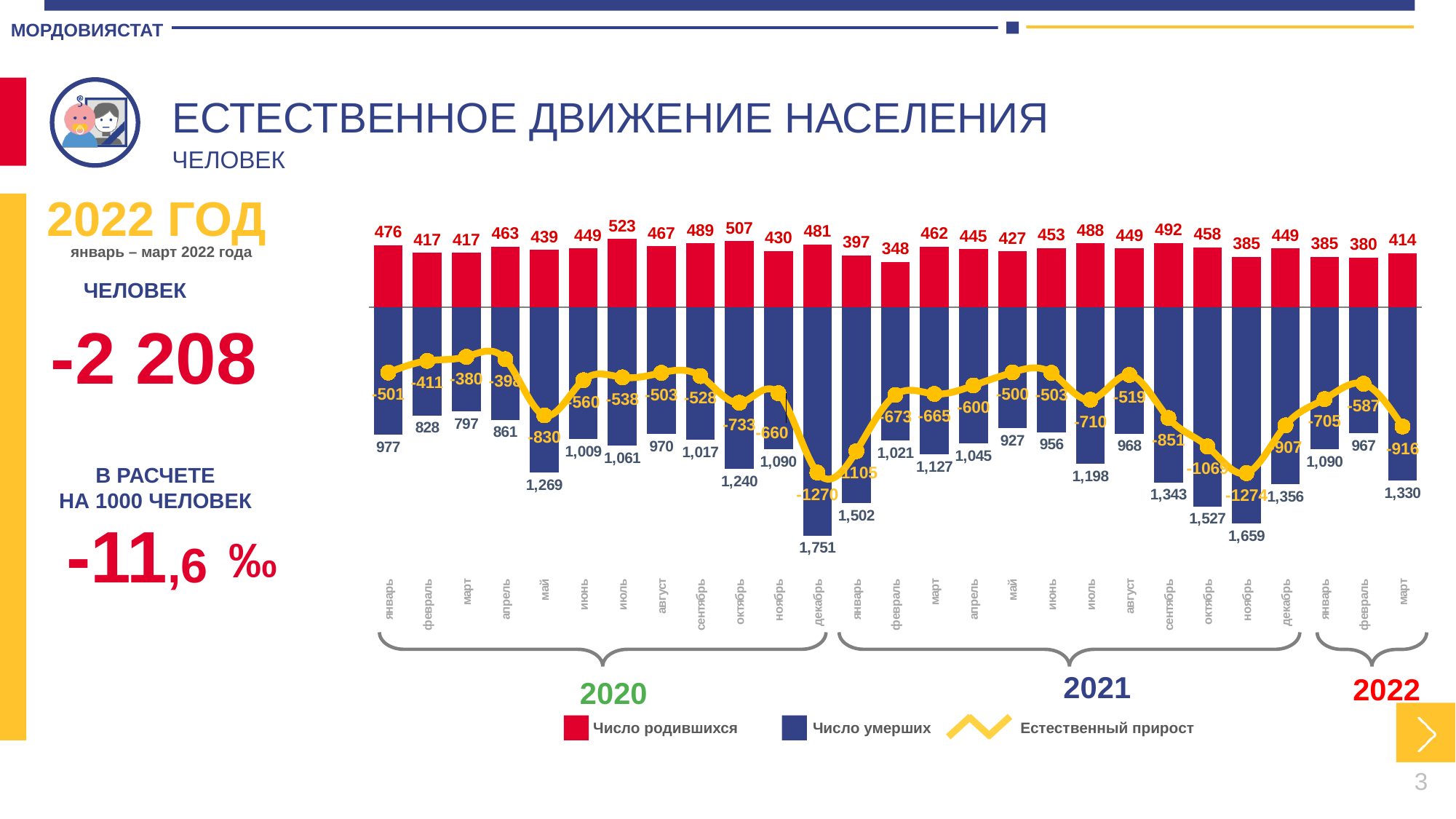
What colour represents the series 'Число умерших' in the legend? Dark blue Which is larger: the number of births in March 2022 or in February 2022? March 2022 (414) What is the number of births (Число родившихся) for July 2020? 523 What is the natural increase (Естественный прирост) value for November 2021? -1274 How many months are plotted on the x axis of the chart? 27 What is the number of deaths for March 2022? 1,330 Which month has the lowest number of births across the whole chart? февраль 2021 (348) Which month has the highest number of deaths across the whole chart? декабрь 2020 (1,751) What kind of chart is shown on the slide? Combined bar and line chart What is the difference between the number of deaths in November 2021 and December 2021? 303 What is the number of deaths (Число умерших) for December 2020? 1,751 How many series does the chart legend list? 3